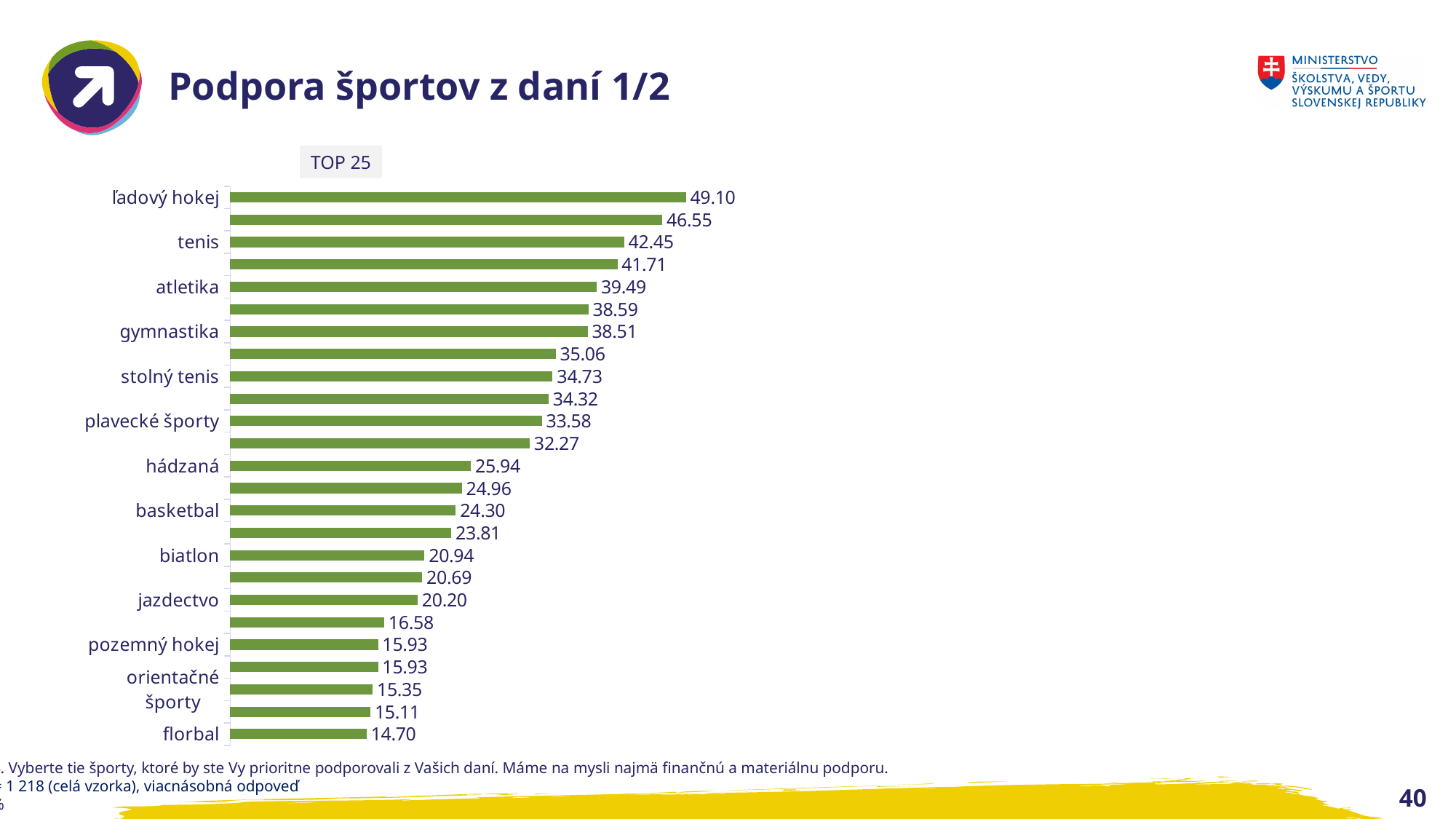
What is the value for tenis? 42.45 Which sport has the highest value? ľadový hokej What is the label shown above the chart? TOP 25 What is the value for hádzaná? 25.94 What is the value for ľadový hokej? 49.10 What kind of chart is shown on the slide? bar chart What is the difference between the values for ľadový hokej and tenis? 6.65 Which has a larger value, basketbal or biatlon? basketbal What is the value for orientačné športy? 15.35 Which sport has the lowest value? florbal What is the value for florbal? 14.70 How many bars are shown in the chart? 25